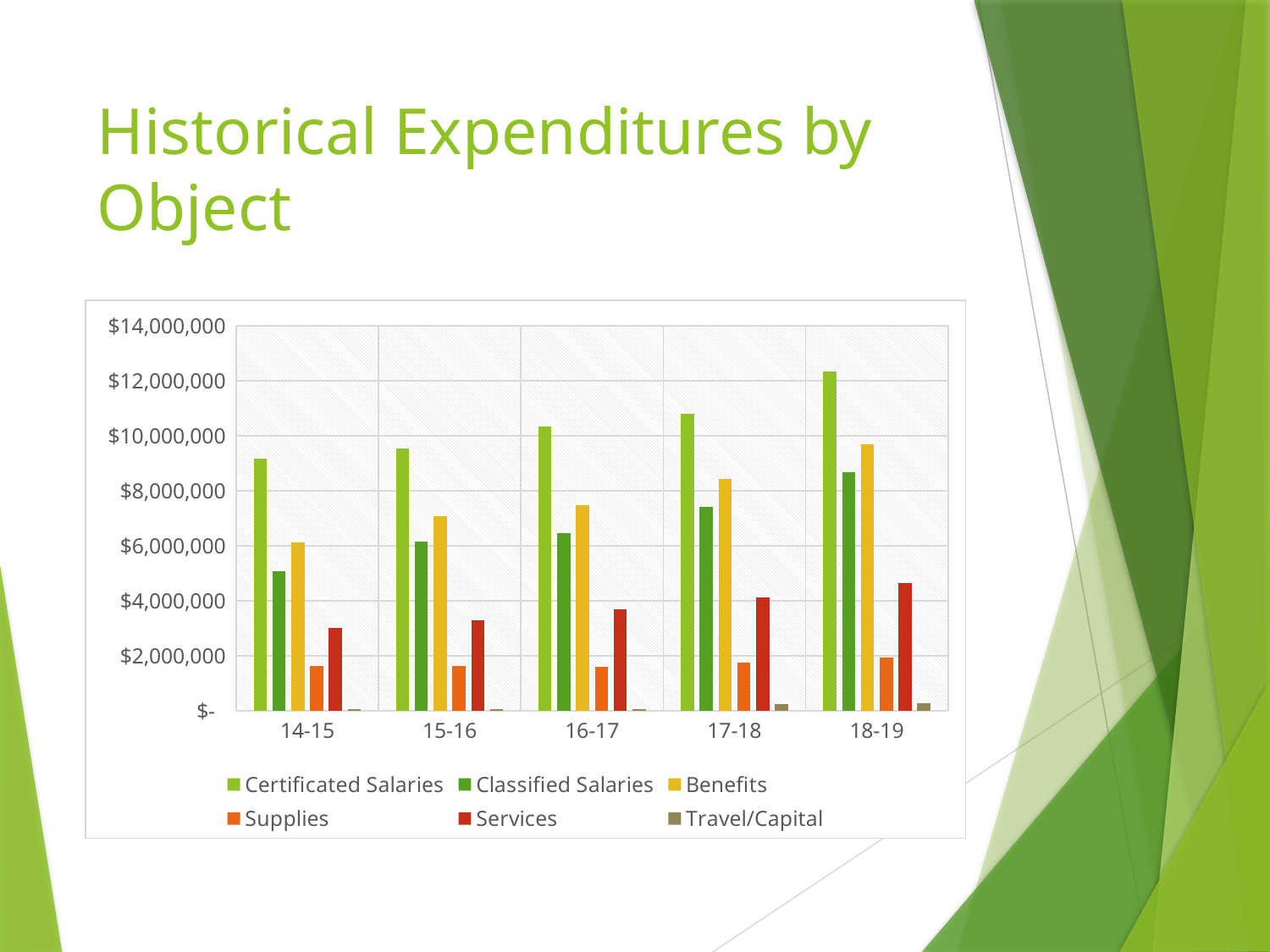
In which year are Certificated Salaries lowest? 14-15 Do Certificated Salaries rise or fall from 14-15 to 18-19? rise What kind of chart is shown on the slide? bar chart In which year are Certificated Salaries highest? 18-19 How many fiscal years are shown on the x axis? 5 Is the value for Certificated Salaries in 18-19 greater or less than $12,000,000? greater Is the value for Services in 14-15 greater or less than $4,000,000? less In 18-19, which is larger: Benefits or Classified Salaries? Benefits Which series has the smallest value in 18-19? Travel/Capital How many series does the legend list? 6 Is the value for Classified Salaries in 14-15 greater or less than $6,000,000? less In 18-19, which is larger: Services or Supplies? Services